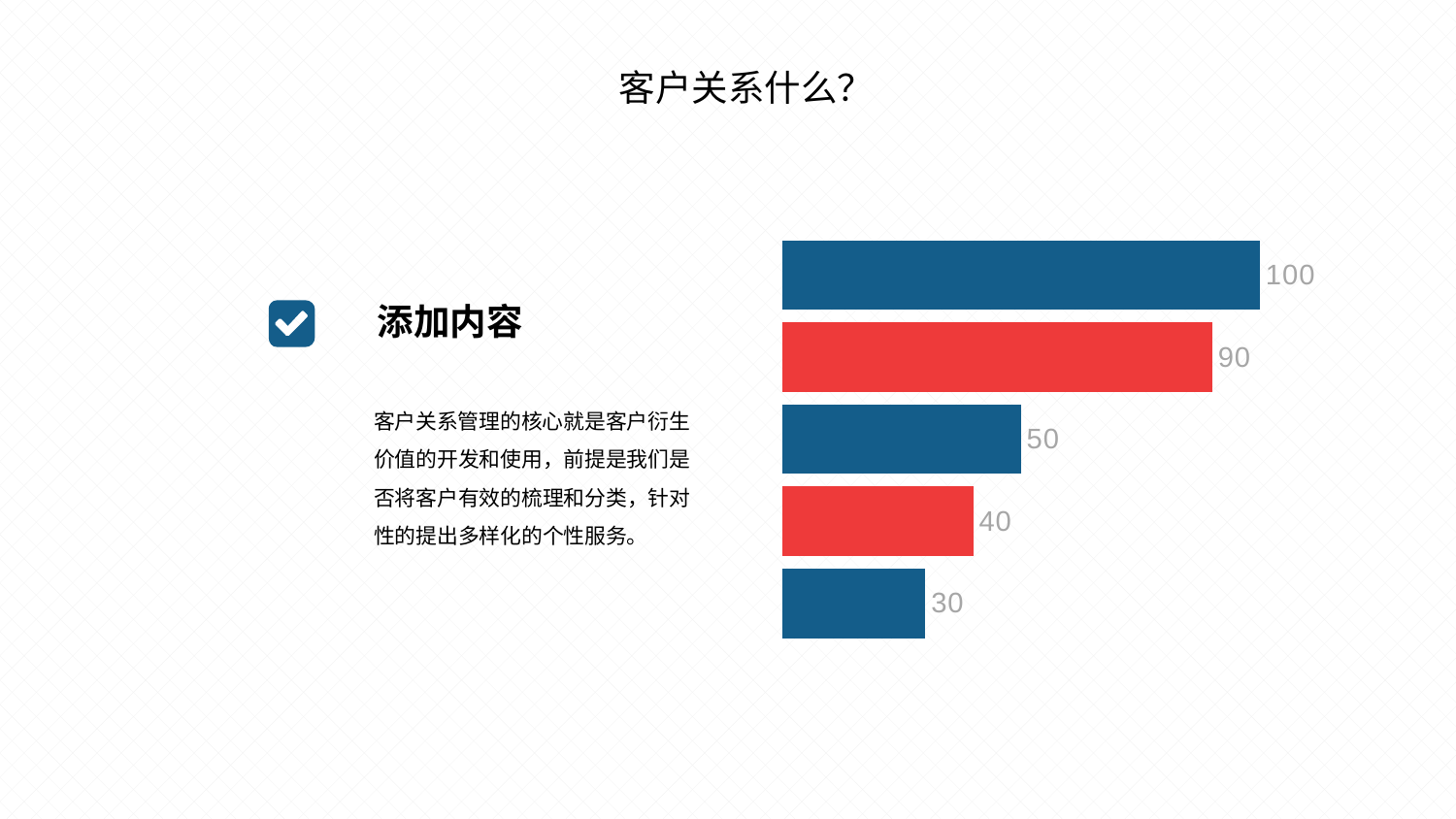
What is the difference between the top bar and the second bar? 10 What is the value of the top bar in the chart? 100 What is the value of the middle (third) bar? 50 Which is larger, the fourth bar from the top or the bottom bar? the fourth bar (40) How many bars does the chart contain? 5 What kind of chart is shown on the slide? bar chart What colour is the second bar from the top? red Which bar has the lowest value? the bottom bar (30) What is the difference between the third bar (50) and the bottom bar (30)? 20 What is the value of the second bar from the top? 90 Which bar has the highest value? the top bar (100) What is the value of the bottom bar in the chart? 30